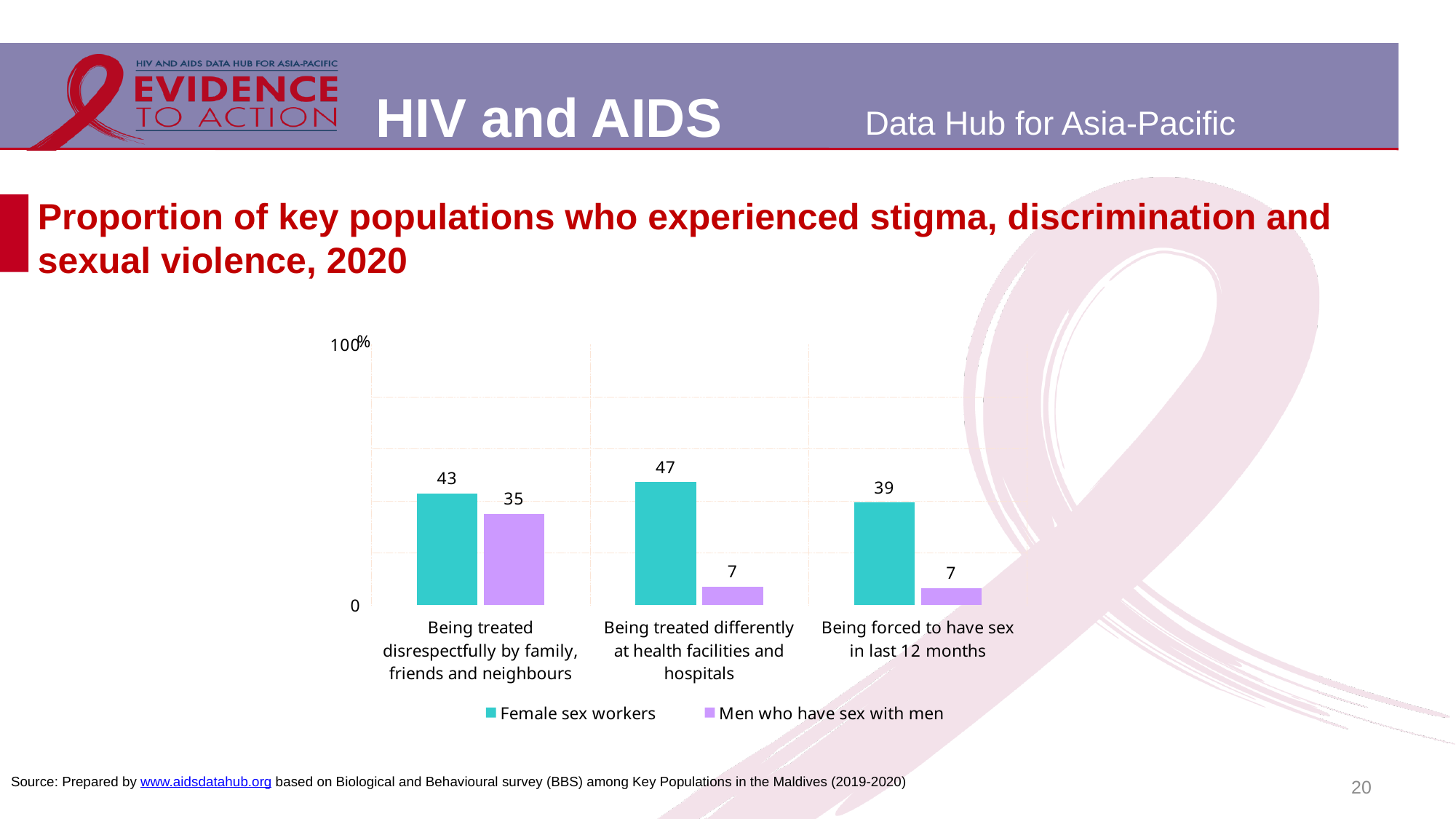
What is the value for Female sex workers for 'Being treated differently at health facilities and hospitals'? 47 What is the value for Men who have sex with men for 'Being treated disrespectfully by family, friends and neighbours'? 35 What is the value for Men who have sex with men for 'Being forced to have sex in last 12 months'? 7 What kind of chart is shown on the slide? Bar chart What is the difference between the Female sex workers values for 'Being treated differently at health facilities and hospitals' and 'Being forced to have sex in last 12 months'? 8 What is the difference between the Female sex workers and Men who have sex with men values for 'Being treated differently at health facilities and hospitals'? 40 How many categories are shown on the x axis? 3 For which category is the Female sex workers value highest? Being treated differently at health facilities and hospitals What is the value for Female sex workers for 'Being treated disrespectfully by family, friends and neighbours'? 43 Which is larger for 'Being treated disrespectfully by family, friends and neighbours': Female sex workers or Men who have sex with men? Female sex workers How many series does the legend list? 2 For which category is the Female sex workers value lowest? Being forced to have sex in last 12 months